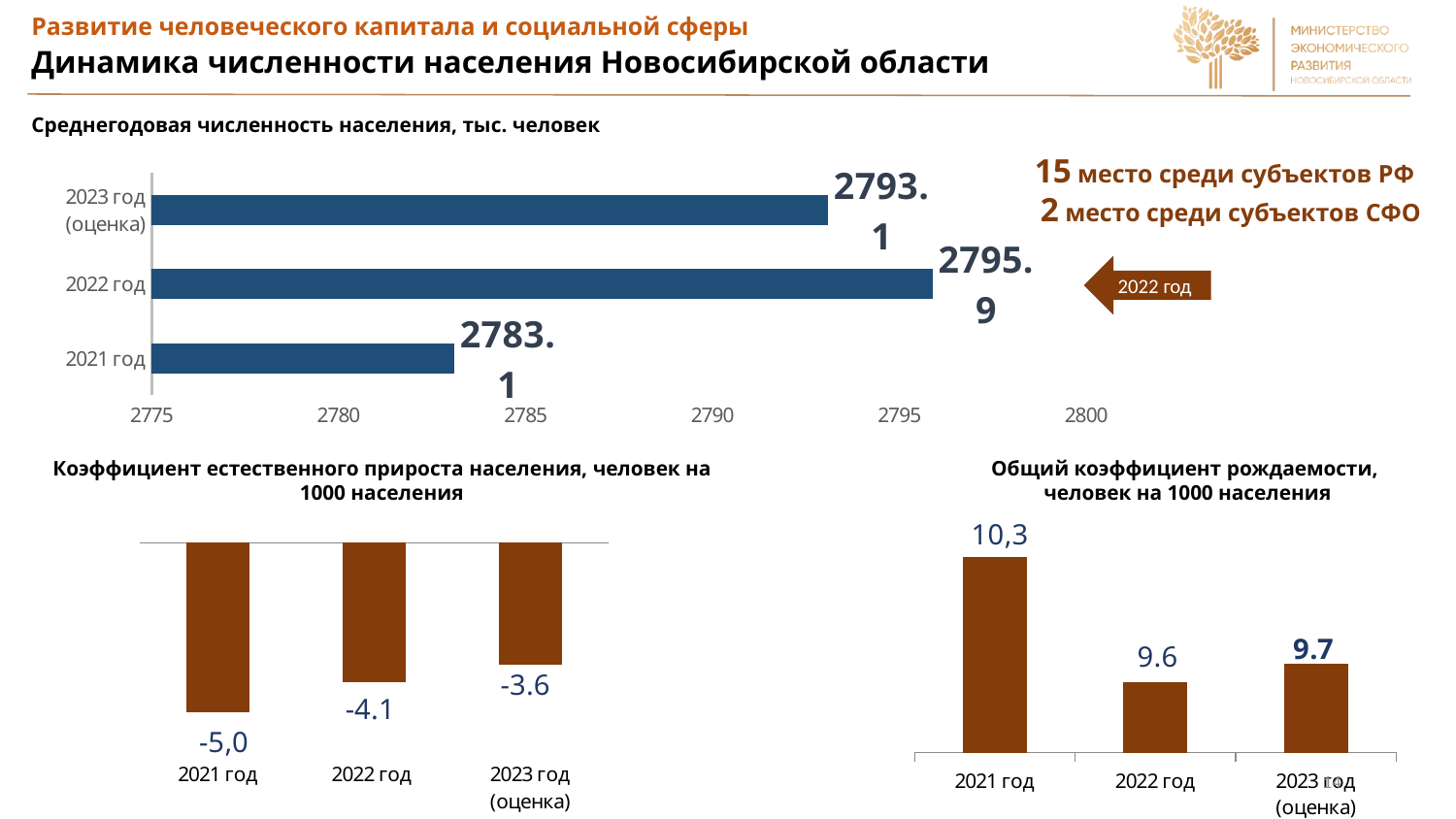
In the chart 'Среднегодовая численность населения, тыс. человек', what is the value for 2022 год? 2795.9 What type of chart is 'Среднегодовая численность населения, тыс. человек'? Bar chart In the chart 'Среднегодовая численность населения, тыс. человек', what is the value for 2021 год? 2783.1 In the chart 'Общий коэффициент рождаемости, человек на 1000 населения', what is the value for 2021 год? 10,3 In the chart 'Коэффициент естественного прироста населения, человек на 1000 населения', what is the value for 2022 год? -4.1 In the chart 'Общий коэффициент рождаемости, человек на 1000 населения', what is the difference between the 2021 год and 2022 год values? 0.7 In the chart 'Среднегодовая численность населения, тыс. человек', which year has the highest value? 2022 год In the chart 'Среднегодовая численность населения, тыс. человек', what is the difference between the 2022 год and 2021 год values? 12.8 In the chart 'Общий коэффициент рождаемости, человек на 1000 населения', how many years are shown? 3 In the chart 'Коэффициент естественного прироста населения, человек на 1000 населения', do the values rise or fall from 2021 to 2023? Rise In the chart 'Коэффициент естественного прироста населения, человек на 1000 населения', which year has the lowest value? 2021 год In the chart 'Общий коэффициент рождаемости, человек на 1000 населения', which is larger: the value for 2022 год or 2023 год (оценка)? 2023 год (оценка)